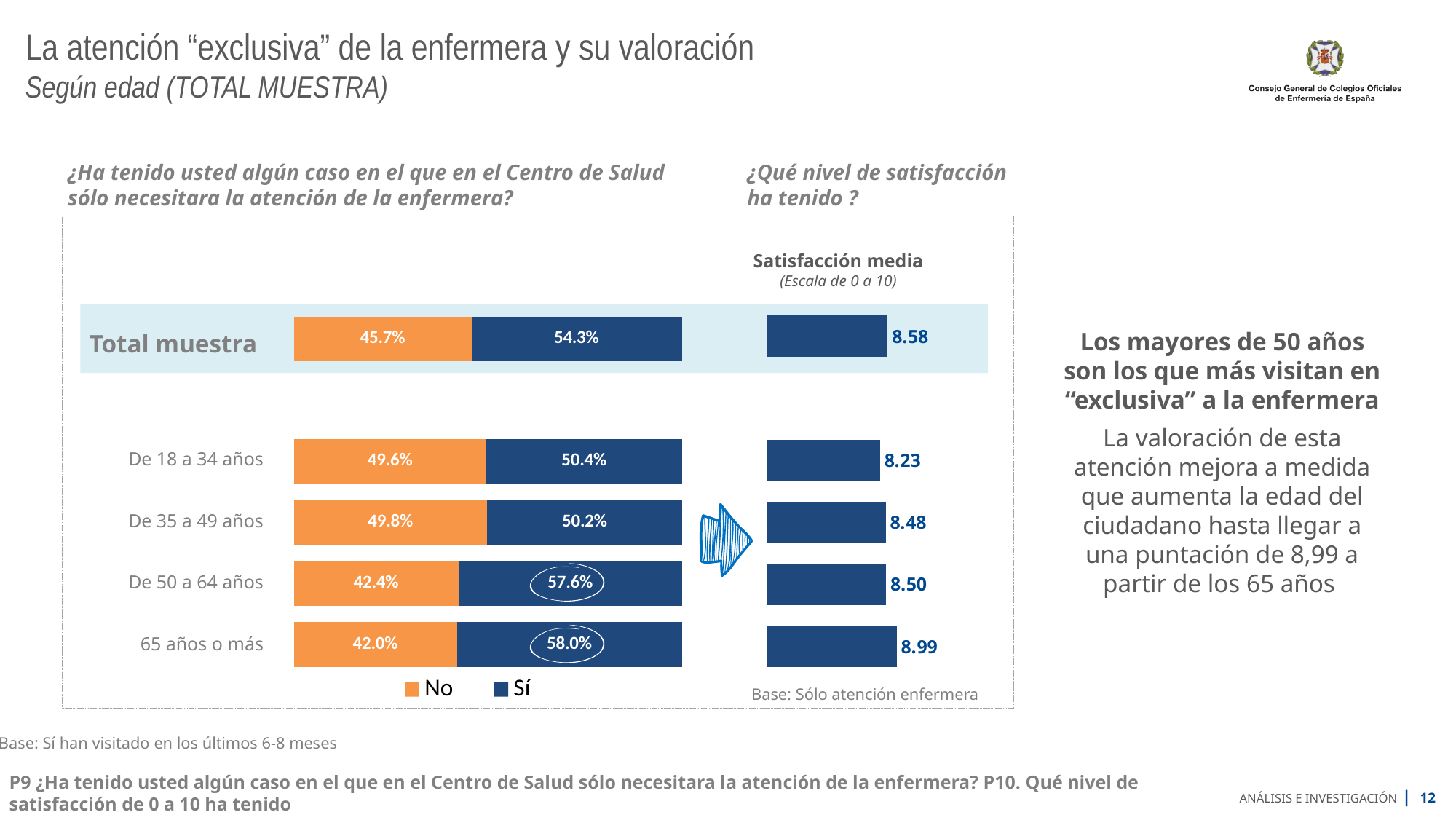
In the left stacked bar chart, how many age groups are shown below 'Total muestra'? 4 In the left stacked bar chart, which has a larger 'Sí' percentage: 'De 50 a 64 años' or 'De 18 a 34 años'? De 50 a 64 años What kind of chart is the left chart showing 'No' and 'Sí' percentages? Stacked bar chart How many series does the legend of the left stacked bar chart list? 2 In the left stacked bar chart, what is the 'Sí' percentage for '65 años o más'? 58.0% In the left stacked bar chart, what is the difference between the 'Sí' and 'No' percentages for 'Total muestra'? 8.6 percentage points In the 'Satisfacción media' chart, do the values rise or fall as the age groups get older (from 'De 18 a 34 años' to '65 años o más')? Rise In the 'Satisfacción media' chart, which age group has the lowest value? De 18 a 34 años In the 'Satisfacción media' chart, what is the value for 'De 35 a 49 años'? 8.48 In the left stacked bar chart, which colour represents 'No'? Orange In the left stacked bar chart, what is the 'No' percentage for 'De 18 a 34 años'? 49.6% In the 'Satisfacción media' chart, which age group has the highest value? 65 años o más